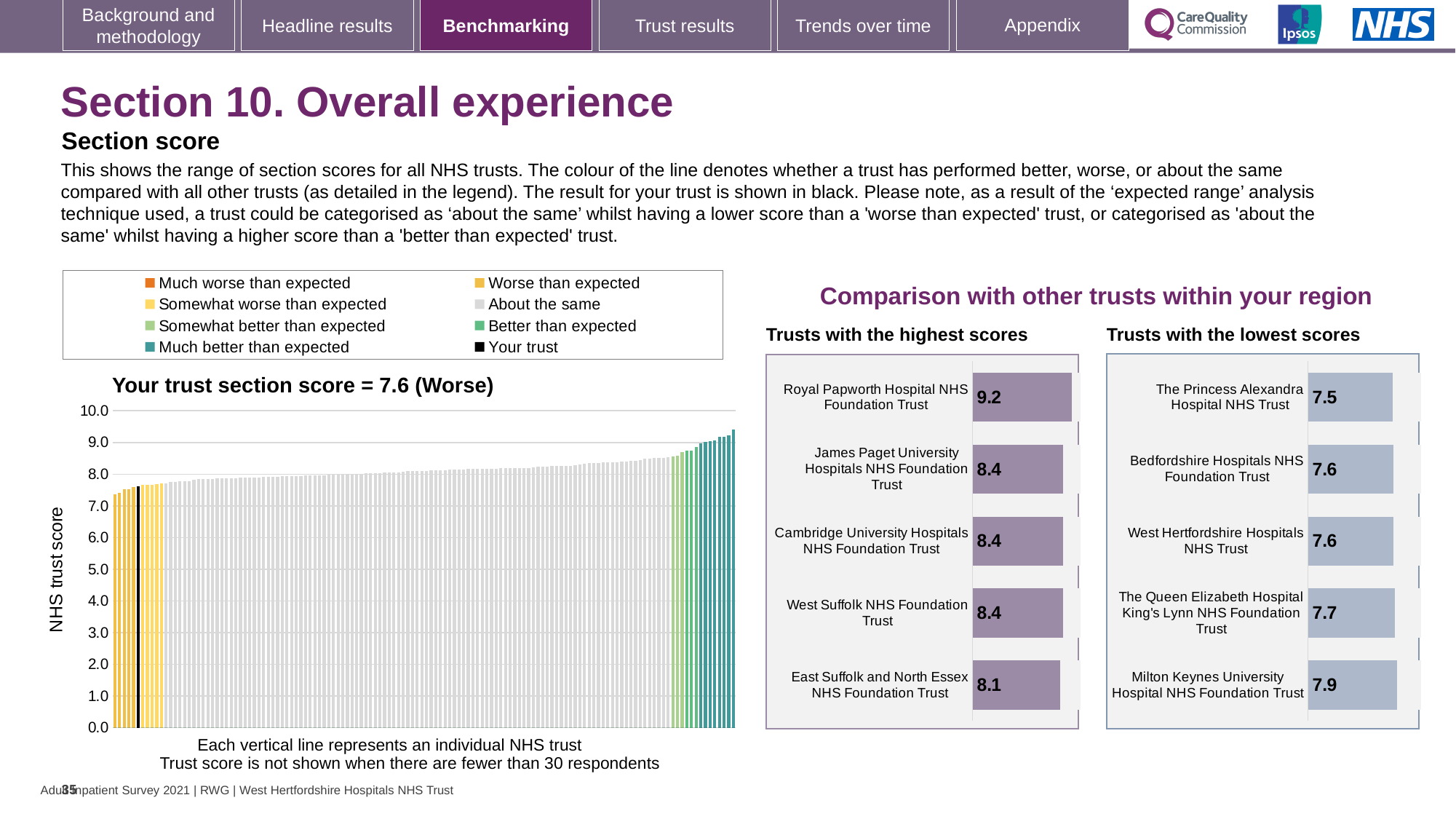
In the 'Trusts with the lowest scores' chart, which trust has the highest score? Milton Keynes University Hospital NHS Foundation Trust In the 'Trusts with the lowest scores' chart, which has the larger score: Milton Keynes University Hospital NHS Foundation Trust or The Queen Elizabeth Hospital King's Lynn NHS Foundation Trust? Milton Keynes University Hospital NHS Foundation Trust In the 'Trusts with the lowest scores' chart, what is the score for The Princess Alexandra Hospital NHS Trust? 7.5 How many trusts are shown in the 'Trusts with the highest scores' chart? 5 How many entries does the legend above the 'Your trust section score' chart list? 8 In the 'Trusts with the highest scores' chart, what is the score for Royal Papworth Hospital NHS Foundation Trust? 9.2 What is the y-axis label of the 'Your trust section score' chart? NHS trust score In the 'Your trust section score' chart, do the trust scores rise or fall from left to right along the x axis? rise In the 'Your trust section score' chart, what is the section score for your trust? 7.6 What kind of chart is the 'Your trust section score = 7.6 (Worse)' chart? bar chart In the 'Trusts with the highest scores' chart, what is the difference between the scores of Royal Papworth Hospital NHS Foundation Trust and East Suffolk and North Essex NHS Foundation Trust? 1.1 In the 'Trusts with the highest scores' chart, which trust has the lowest score? East Suffolk and North Essex NHS Foundation Trust